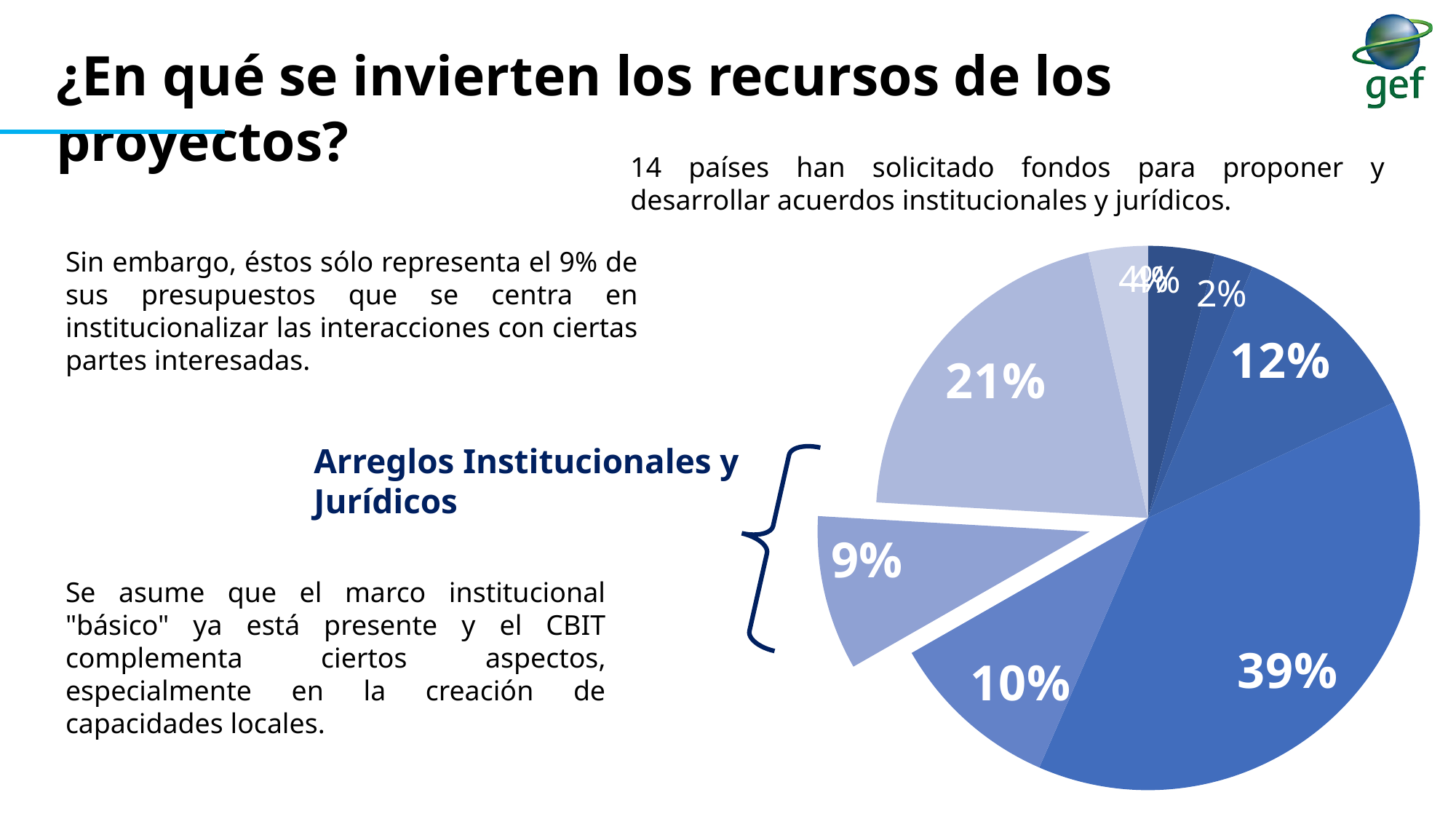
What is the value of the largest slice in the pie chart? 39% What share of the pie does the Arreglos Institucionales y Jurídicos slice represent? 9% What kind of chart is shown on the slide? pie chart What is the difference in percentage points between the largest slice (39%) and the Arreglos Institucionales y Jurídicos slice (9%)? 30 percentage points Does the pie chart include a legend? No Which slice is pulled out (exploded) from the rest of the pie chart? Arreglos Institucionales y Jurídicos (9%) Which is larger, the Arreglos Institucionales y Jurídicos slice or the slice labelled 21%? the slice labelled 21%